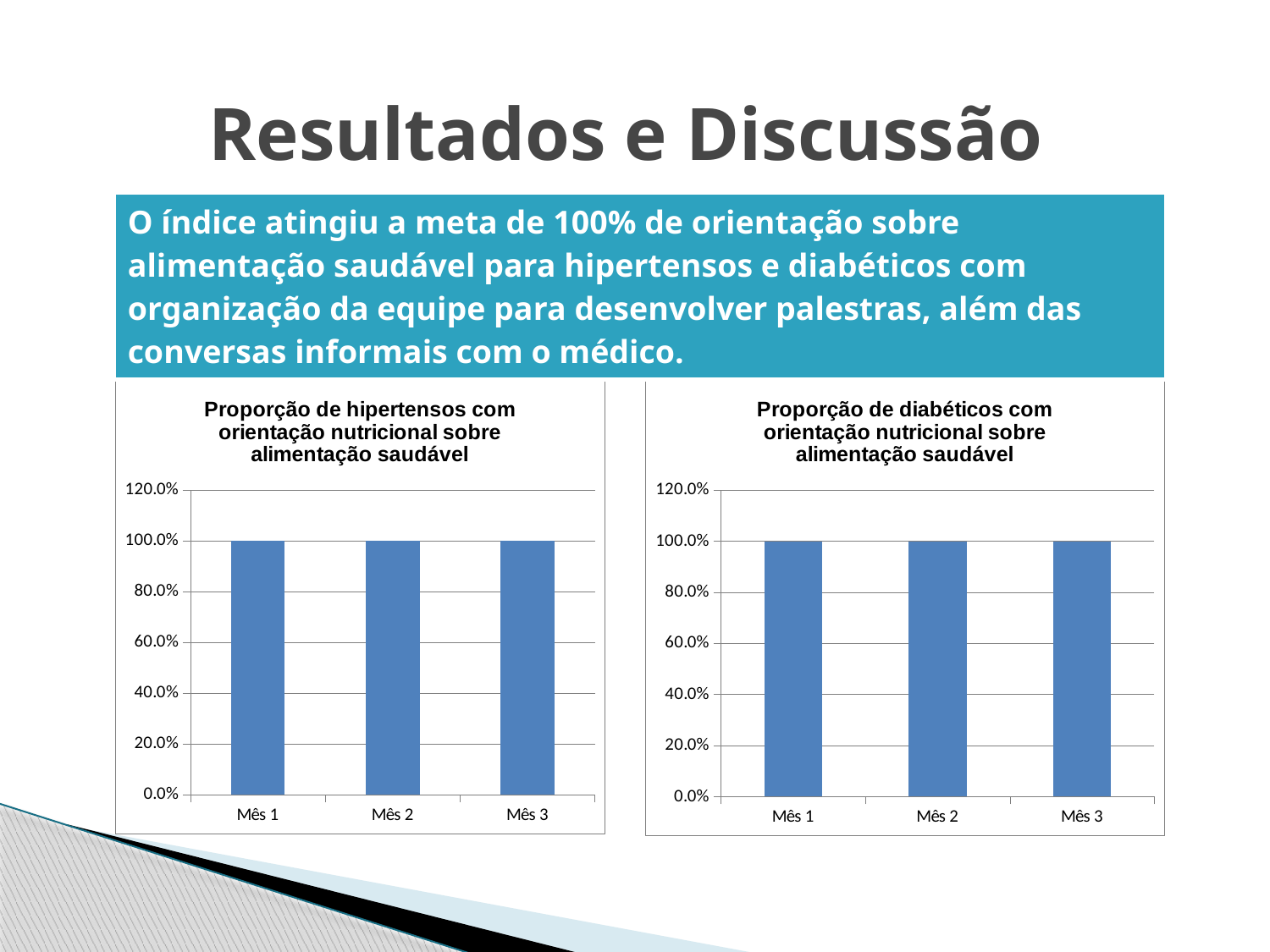
What is the title of the chart on the left side of the slide? Proporção de hipertensos com orientação nutricional sobre alimentação saudável In the left chart (hipertensos), do the values rise, fall or stay the same from Mês 1 to Mês 3? Stay the same In the chart titled 'Proporção de diabéticos com orientação nutricional sobre alimentação saudável', what is the value for Mês 3? 100.0% What kind of chart is the chart titled 'Proporção de diabéticos com orientação nutricional sobre alimentação saudável'? Bar chart In the right chart (diabéticos), what is the value for Mês 2? 100.0% In the left chart (hipertensos), what is the value for Mês 2? 100.0% In the chart titled 'Proporção de hipertensos com orientação nutricional sobre alimentação saudável', what is the value for Mês 1? 100.0% In the right chart (diabéticos), is the value for Mês 1 greater or less than 80.0%? greater What is the highest value shown on the y axis of the right chart (diabéticos)? 120.0% How many bars are plotted in the right chart (diabéticos)? 3 In the left chart (hipertensos), is the value for Mês 3 greater or less than 60.0%? greater How many categories are shown on the x axis of the left chart (hipertensos)? 3